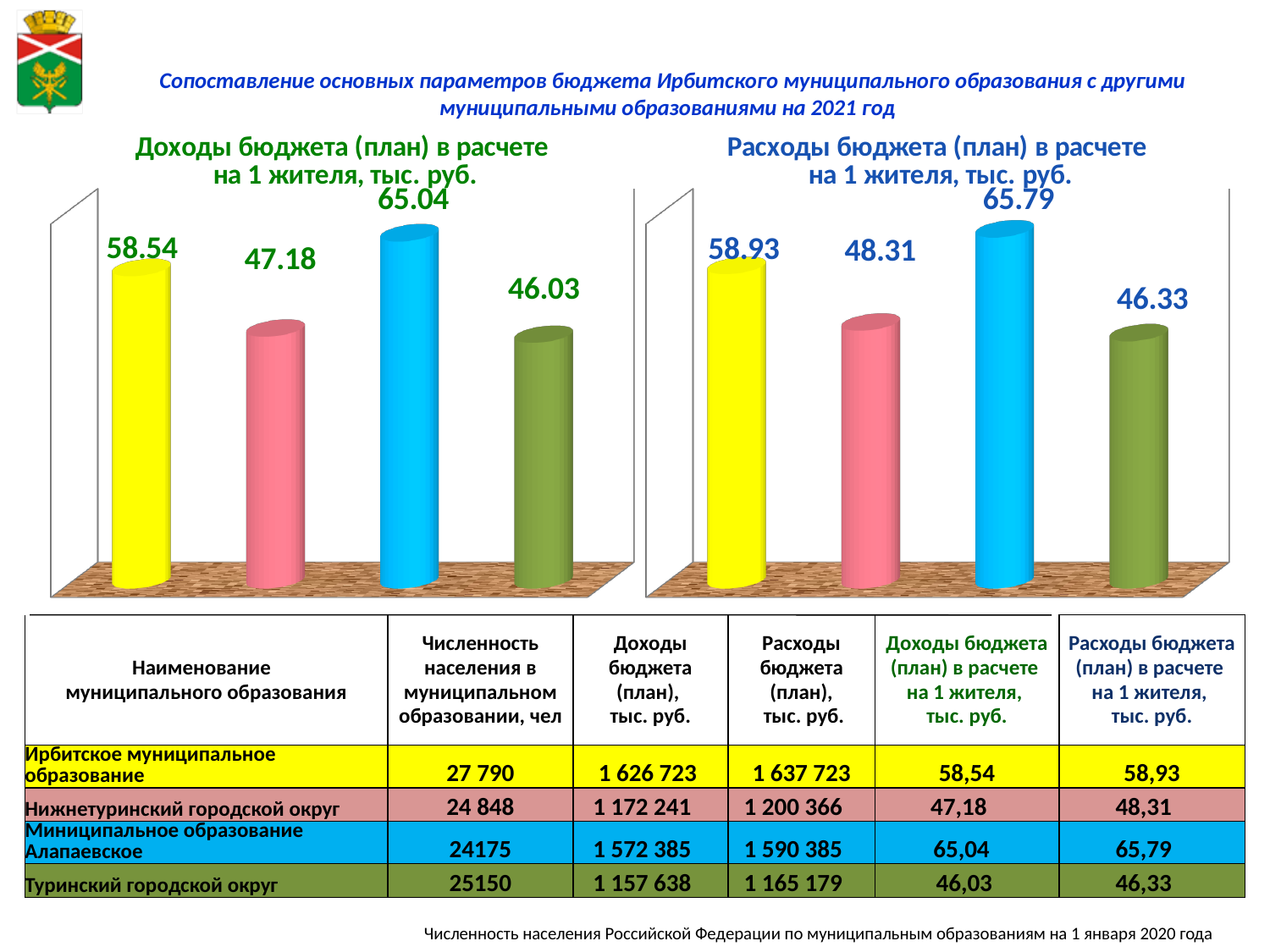
On the chart titled "Расходы бюджета (план) в расчете на 1 жителя, тыс. руб.", what value is shown on the blue bar? 65.79 On the chart titled "Доходы бюджета (план) в расчете на 1 жителя, тыс. руб.", what value is shown on the yellow bar? 58.54 On the left chart (Доходы бюджета), what value is shown on the green bar? 46.03 On the right chart (Расходы бюджета), what value is shown on the pink bar? 48.31 On the left chart (Доходы бюджета), which is larger: the yellow bar or the pink bar? the yellow bar On the left chart (Доходы бюджета), which bar has the highest value? the blue bar (65.04) On the left chart (Доходы бюджета), what is the difference between the blue bar and the green bar? 19.01 What type of chart is the left chart titled "Доходы бюджета (план) в расчете на 1 жителя, тыс. руб."? bar chart What is the title of the right chart on the slide? Расходы бюджета (план) в расчете на 1 жителя, тыс. руб. On the right chart (Расходы бюджета), which bar has the lowest value? the green bar (46.33) How many bars are plotted on the right chart (Расходы бюджета)? 4 On the right chart (Расходы бюджета), what is the difference between the yellow bar and the pink bar? 10.62